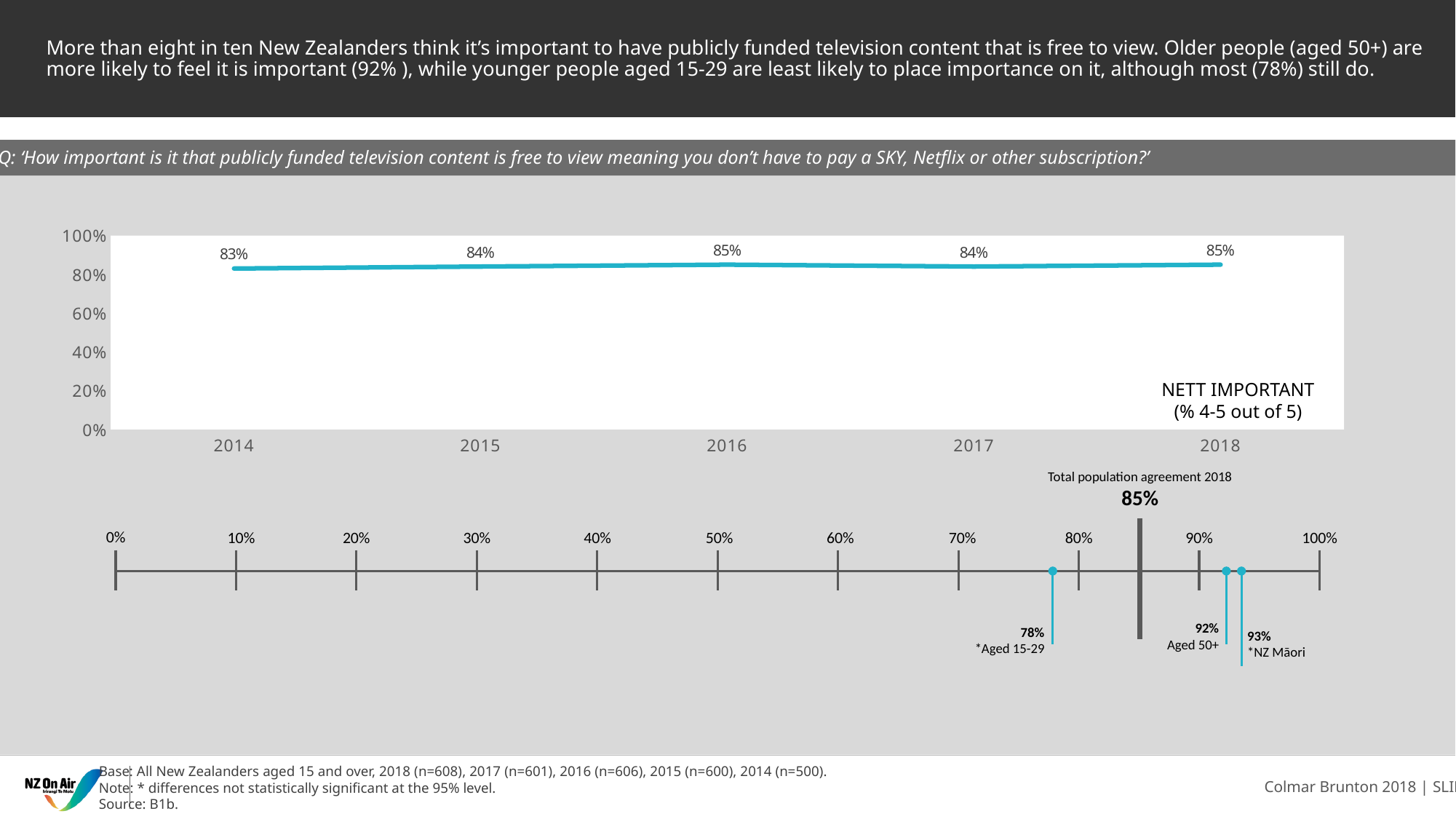
In the top line chart, does the value rise or fall from 2014 to 2016? Rise In the lower scale chart, which is larger: the value for Aged 50+ or the value for Aged 15-29? Aged 50+ In the top line chart, which year has the lowest value? 2014 In the top line chart, how many years are plotted? 5 In the lower scale chart, what is the total population agreement for 2018? 85% In the lower scale chart, what is the value for NZ Māori? 93% In the lower scale chart, what is the value for Aged 15-29? 78% In the top line chart, what is the value for 2016? 85% What type of chart is the top chart on the slide? Line chart In the top line chart, what is the difference between the 2018 value and the 2014 value? 2 percentage points In the top line chart, what is the NETT IMPORTANT value for 2014? 83% In the top line chart, what is the value for 2017? 84%